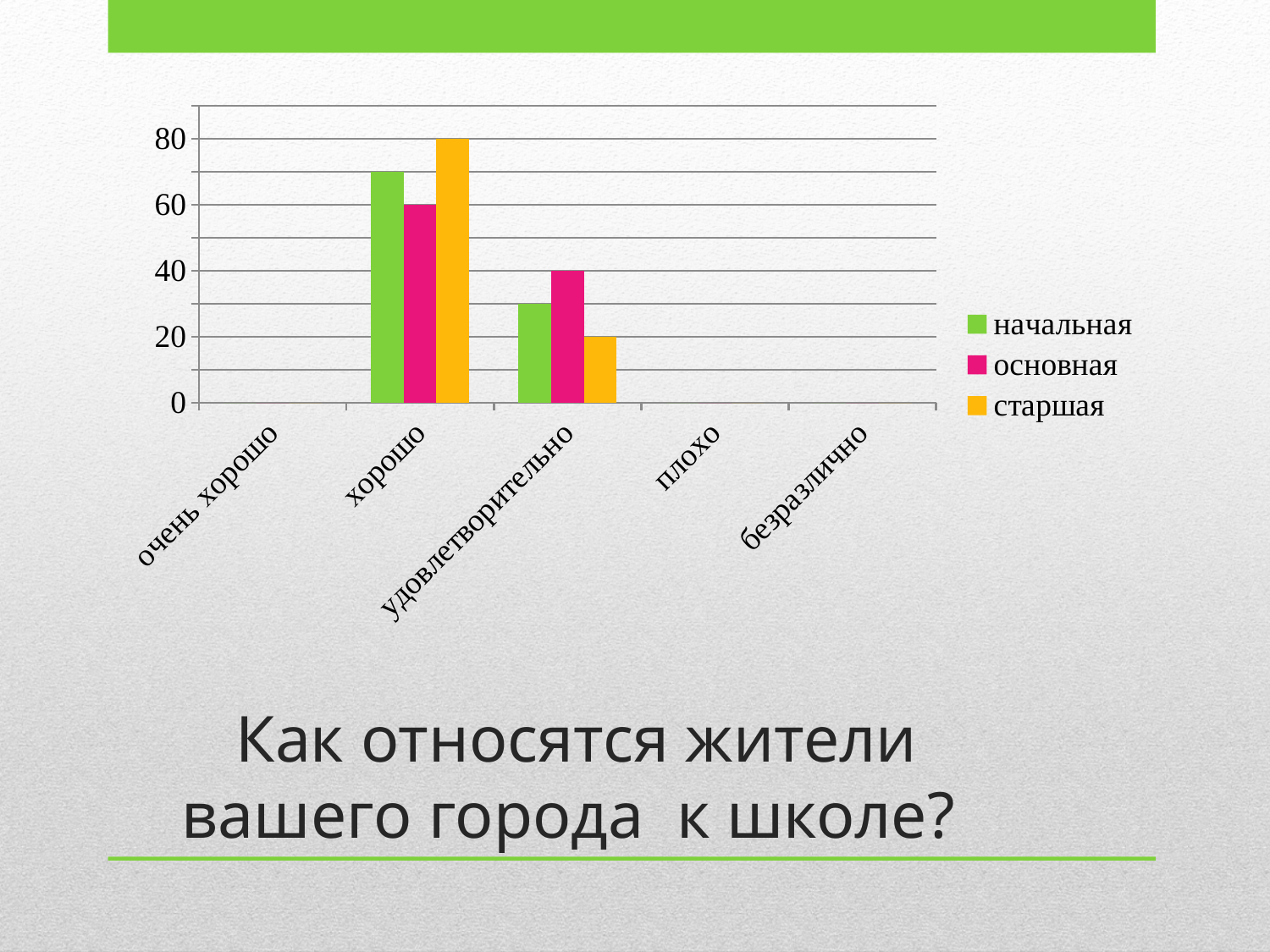
What is the difference between the старшая values for хорошо and удовлетворительно? 60 What is the value for старшая in the удовлетворительно category? 20 What is the value for основная in the хорошо category? 60 Is the value for начальная in the хорошо category greater or less than 60? greater Which series has the lowest value in the удовлетворительно category? старшая How many categories are shown on the x axis? 5 Which series has the highest value in the хорошо category? старшая What kind of chart is shown on the slide? bar chart What is the value for старшая in the хорошо category? 80 Is the value for начальная in the удовлетворительно category greater or less than 40? less How many series does the legend list? 3 What is the value for основная in the удовлетворительно category? 40